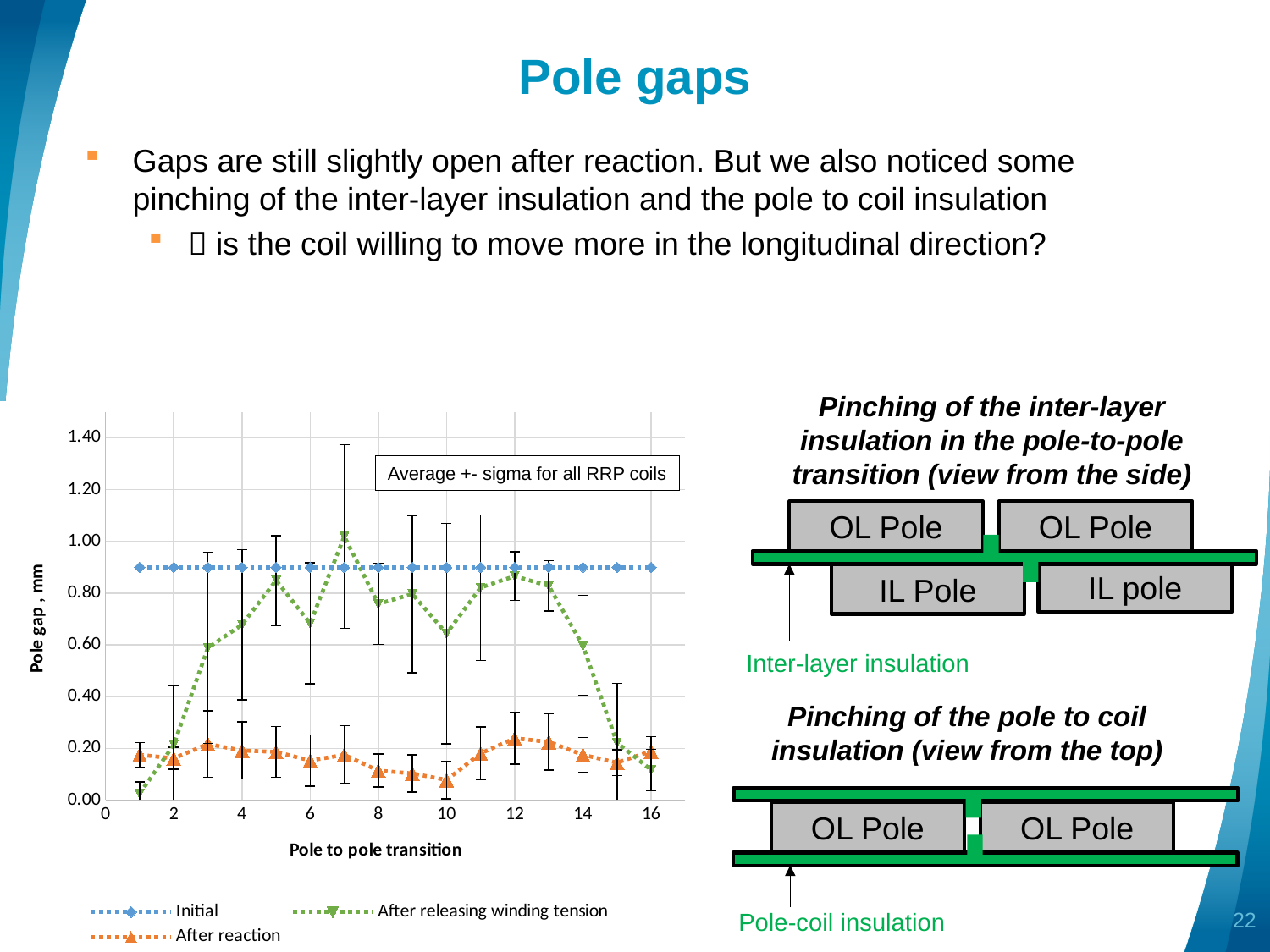
Which series has the highest value at pole to pole transition 3? Initial What is the title of the chart's horizontal axis? Pole to pole transition At pole to pole transition 1, which series has the larger value: Initial or After reaction? Initial Does the Initial series rise, fall or stay flat across the pole to pole transitions? stays flat Is the After releasing winding tension value at pole to pole transition 1 greater or less than 0.20? less At pole to pole transition 7, which series has the larger value: After releasing winding tension or After reaction? After releasing winding tension Is the After reaction value at pole to pole transition 10 greater or less than 0.20? less How many pole to pole transitions are plotted for each series? 16 What kind of chart is shown on the slide? line chart Is the Initial value at pole to pole transition 8 greater or less than 0.80? greater How many series does the chart legend list? 3 What is the title of the chart's vertical axis? Pole gap , mm